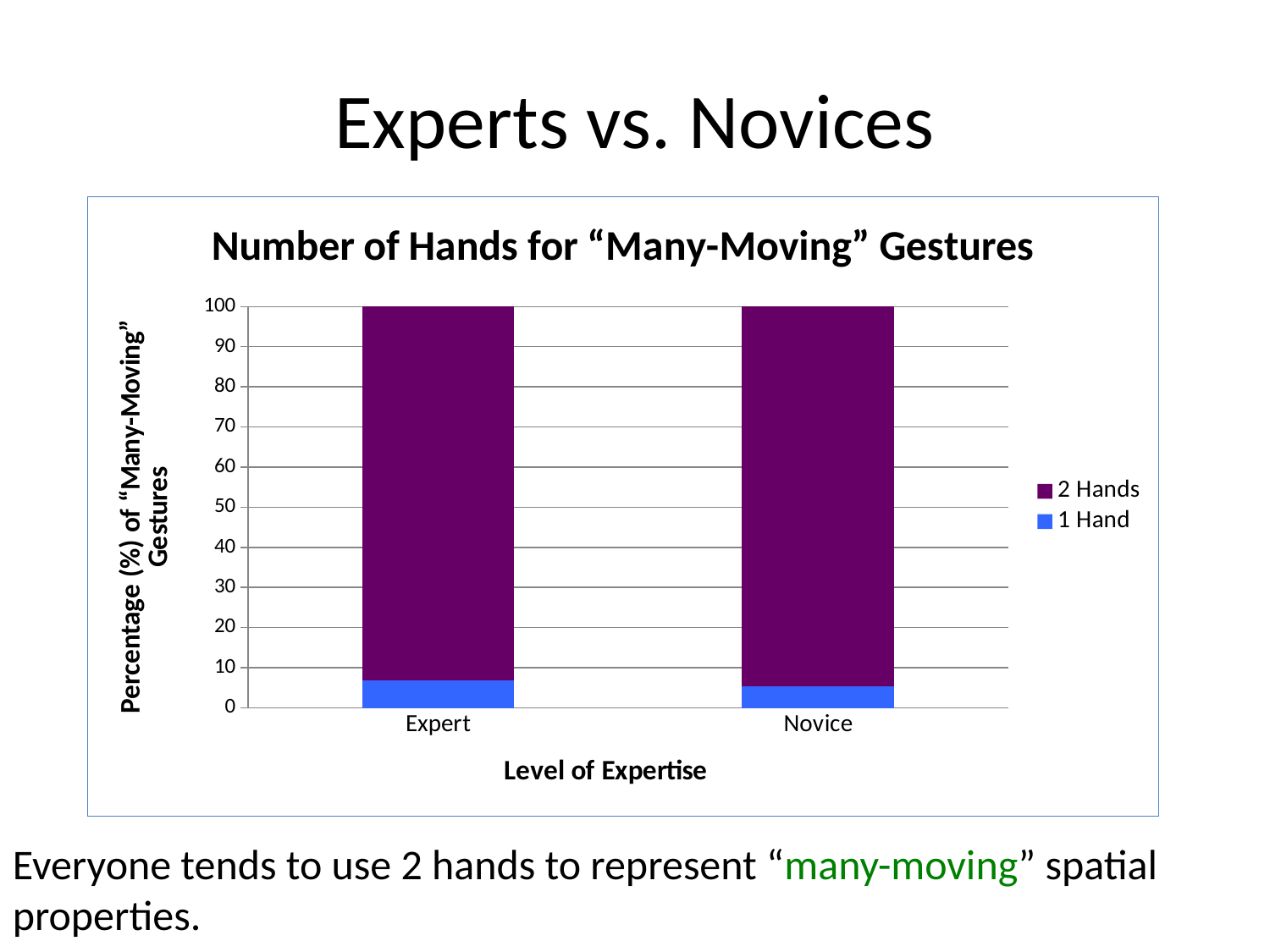
What is the total height of the stacked bar for Expert? 100 What is the title of the chart? Number of Hands for "Many-Moving" Gestures What is the total height of the stacked bar for Novice? 100 How many series does the chart's legend list? 2 Which series is larger for Expert, 1 Hand or 2 Hands? 2 Hands What kind of chart is shown on the slide? Stacked bar chart Is the 1 Hand value for Expert greater or less than 10? less Is the 1 Hand value for Novice greater or less than 10? less What is the label of the x axis? Level of Expertise Is the 2 Hands value for Novice greater or less than 90? greater How many categories are shown on the x axis of the chart? 2